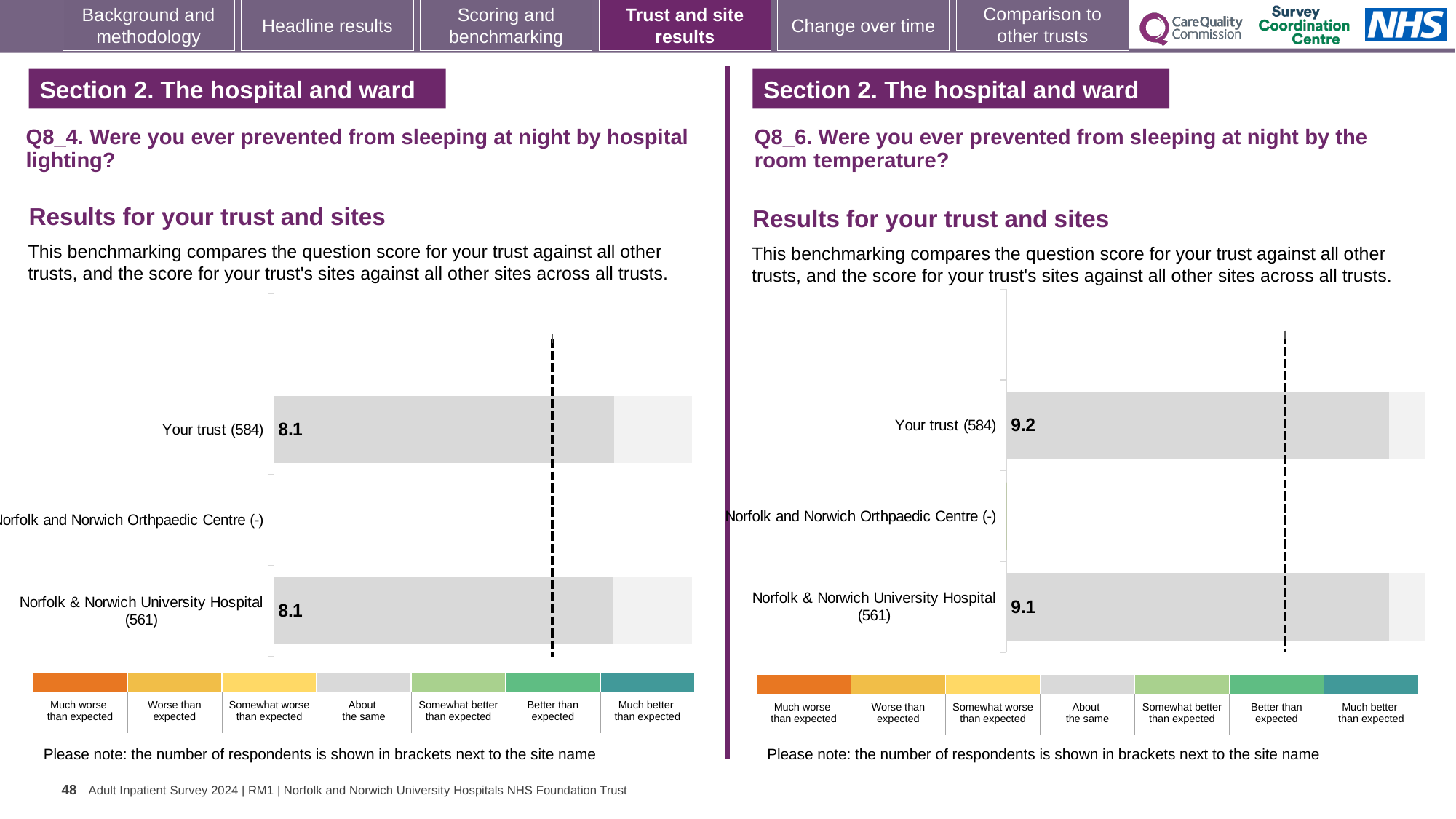
In the Q8_6 chart (room temperature), how many respondents are shown in brackets for Your trust? 584 Is the score for Your trust (584) in the Q8_4 chart (hospital lighting) higher or lower than the score for Your trust (584) in the Q8_6 chart (room temperature)? Lower In the Q8_4 chart (hospital lighting), what is the score for Norfolk & Norwich University Hospital (561)? 8.1 In the Q8_6 chart (room temperature), which has the higher score: Your trust (584) or Norfolk & Norwich University Hospital (561)? Your trust (584) In the Q8_6 chart (room temperature), what is the score for Norfolk & Norwich University Hospital (561)? 9.1 In the Q8_4 chart (hospital lighting), how many categories are listed on the vertical axis? 3 In the Q8_6 chart (room temperature), what is the score for Your trust (584)? 9.2 What type of chart is used in the Q8_4 chart (hospital lighting)? Bar chart In the Q8_4 chart (hospital lighting), what is the score for Your trust (584)? 8.1 In the Q8_4 chart (hospital lighting), which category has no bar plotted? Norfolk and Norwich Orthpaedic Centre (-) In the Q8_6 chart (room temperature), what is the difference between the score for Your trust (584) and the score for Norfolk & Norwich University Hospital (561)? 0.1 In the Q8_6 chart (room temperature), how many categories are listed on the vertical axis? 3